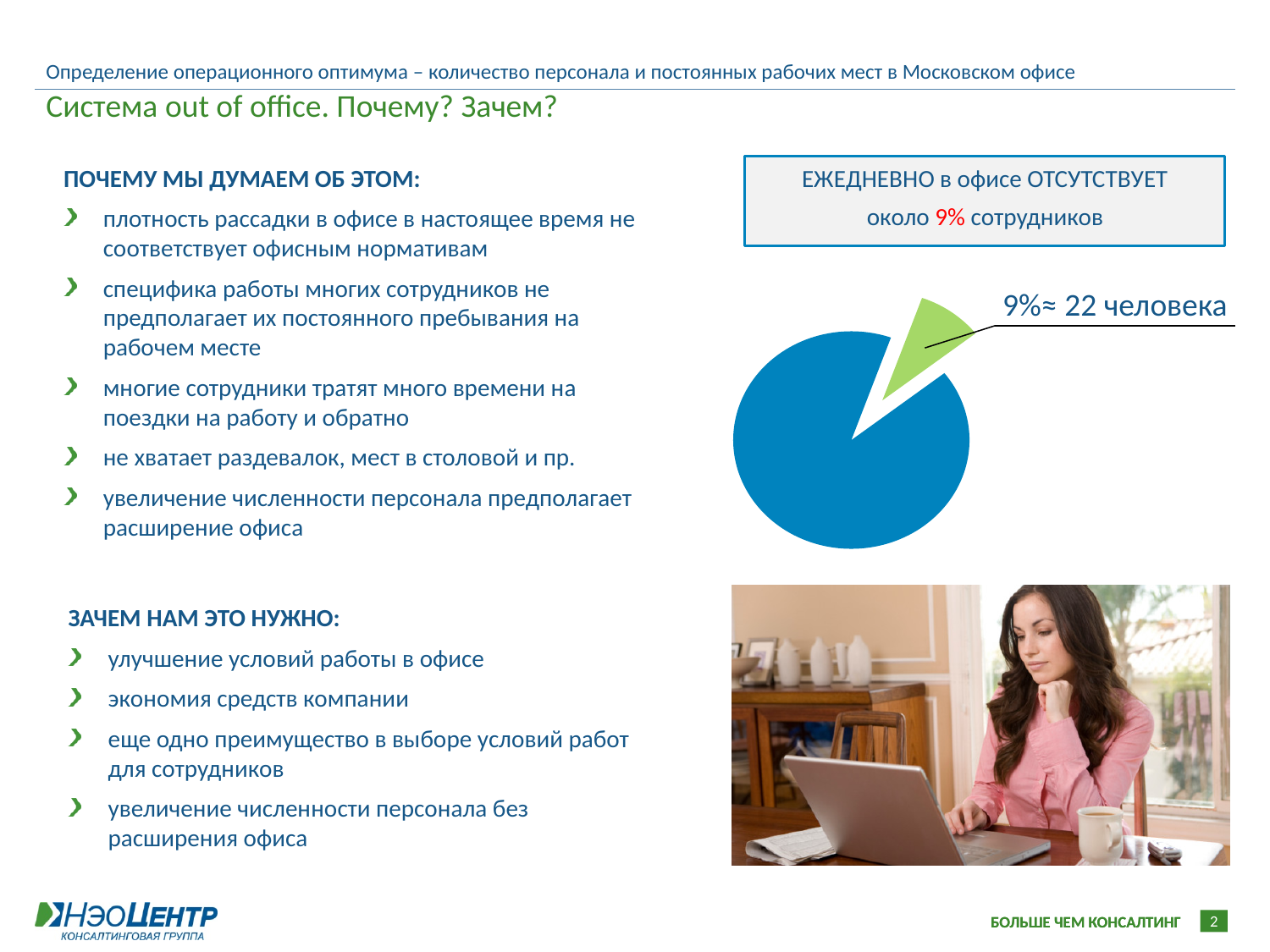
How many slices does the pie chart have? 2 Which slice of the pie chart is the largest, the blue one or the green one? the blue one What kind of chart is shown on the right side of the slide? pie chart According to the label on the pie chart, how many people does the 9% slice correspond to? 22 человека Which slice of the pie chart is the smallest? the green slice (9%) Does the pie chart display a legend? No What colour is the slice of the pie chart that is pulled out from the rest? green What is the full text of the data label attached to the green slice of the pie chart? 9%≈ 22 человека Is the green slice of the pie chart larger or smaller than the blue slice? smaller What share of the pie does the small green slice represent? 9%